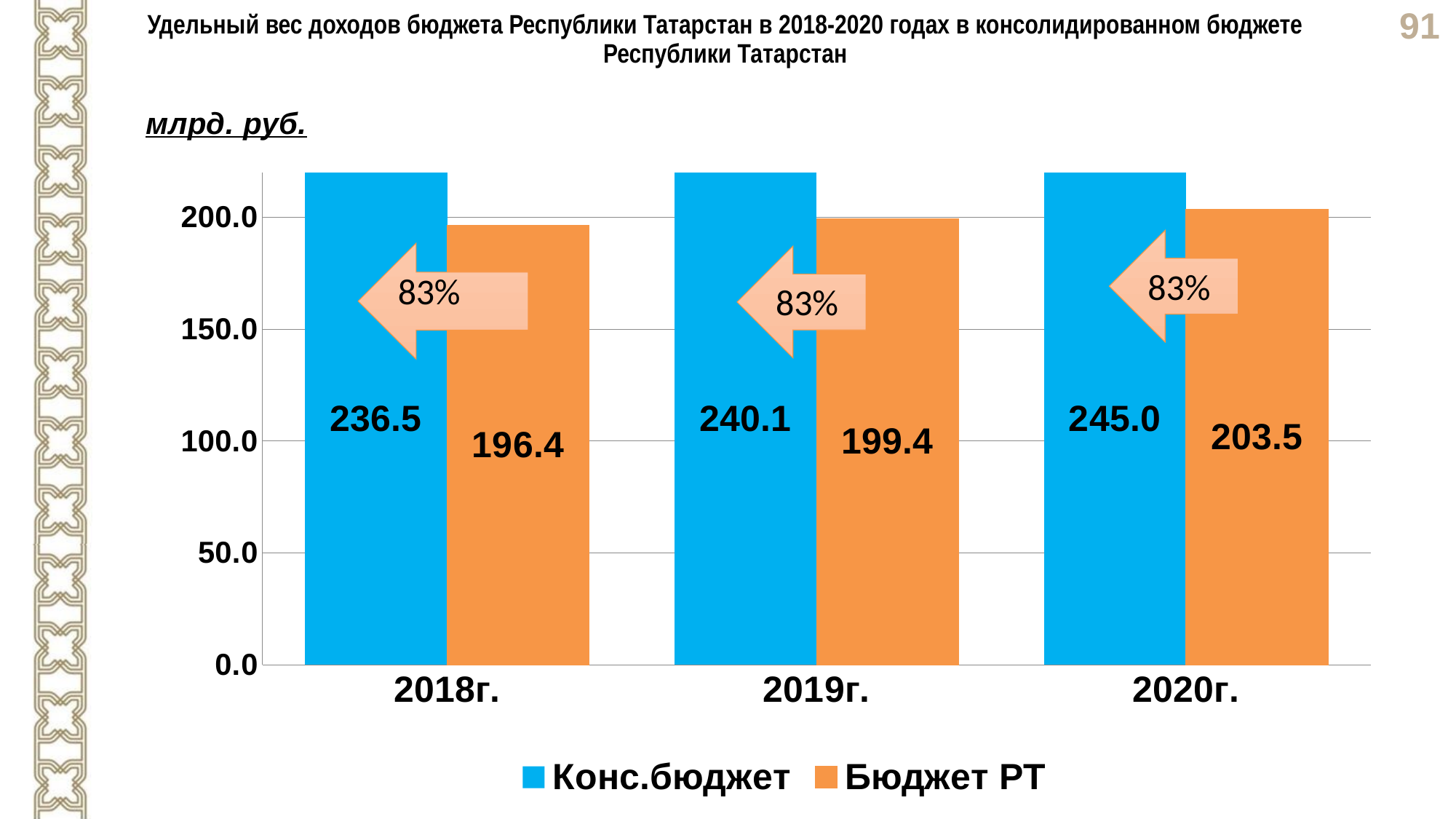
Is the value for Бюджет РТ in 2018г. greater or less than 200.0? less Which is larger in 2020г., Конс.бюджет or Бюджет РТ? Конс.бюджет What kind of chart is shown on the slide? bar chart In which year is the Бюджет РТ value lowest? 2018г. Do the Бюджет РТ values rise or fall from 2018г. to 2020г.? rise In which year is the Конс.бюджет value highest? 2020г. What is the difference between Конс.бюджет and Бюджет РТ in 2019г.? 40.7 How many series does the legend list? 2 How many years are shown on the x axis? 3 What is the value for Бюджет РТ in 2019г.? 199.4 What is the value for Конс.бюджет in 2018г.? 236.5 What is the value for Бюджет РТ in 2020г.? 203.5